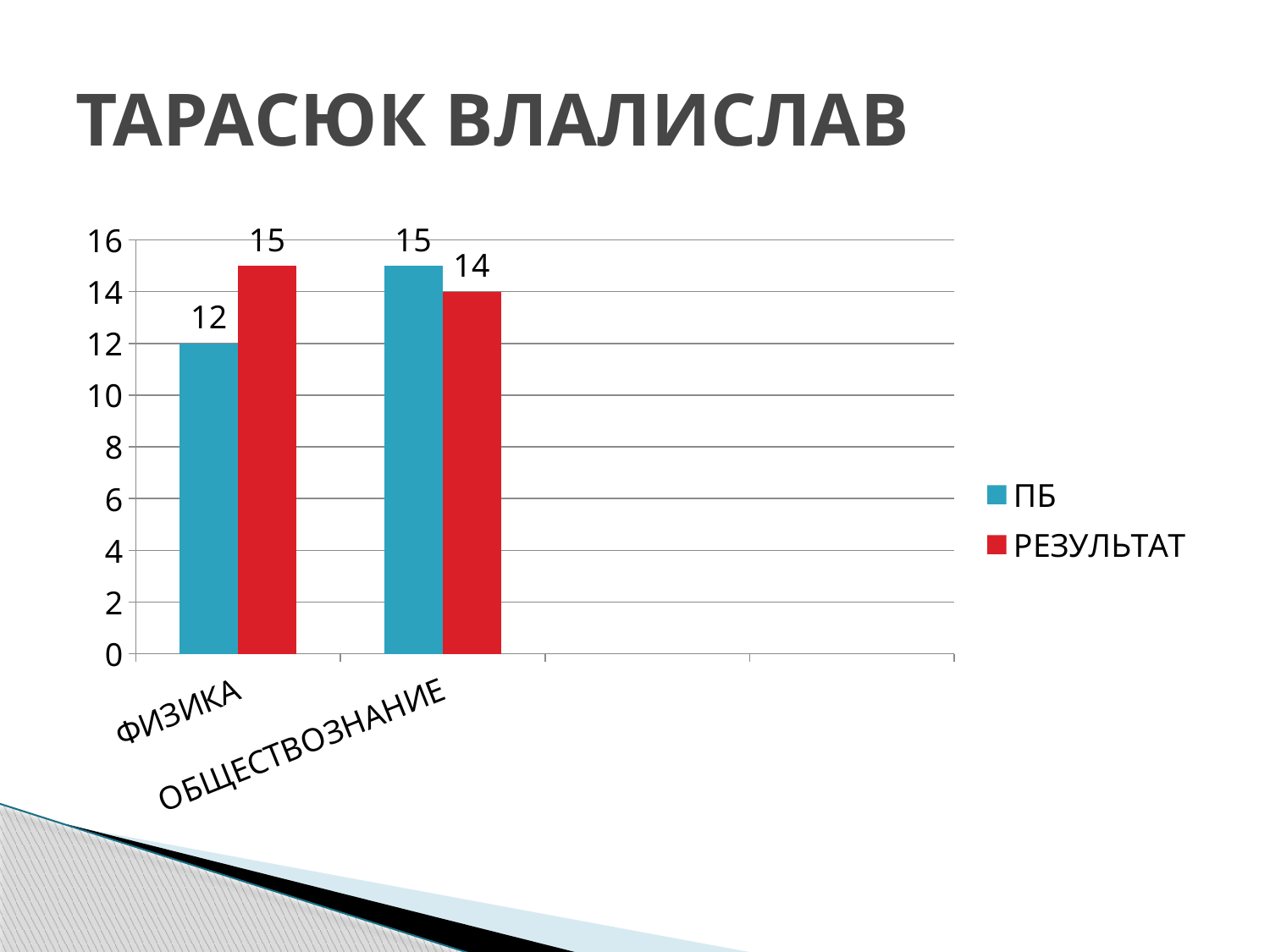
What is the ПБ value for ФИЗИКА? 12 How many series does the legend list? 2 Which category has the highest РЕЗУЛЬТАТ value? ФИЗИКА What is the ПБ value for ОБЩЕСТВОЗНАНИЕ? 15 How many categories are shown on the x axis? 2 What is the difference between the ПБ and РЕЗУЛЬТАТ values for ОБЩЕСТВОЗНАНИЕ? 1 What is the РЕЗУЛЬТАТ value for ФИЗИКА? 15 What kind of chart is shown on the slide? Bar chart What is the difference between the РЕЗУЛЬТАТ and ПБ values for ФИЗИКА? 3 Which category has the lowest ПБ value? ФИЗИКА What is the РЕЗУЛЬТАТ value for ОБЩЕСТВОЗНАНИЕ? 14 For ФИЗИКА, which is larger: ПБ or РЕЗУЛЬТАТ? РЕЗУЛЬТАТ